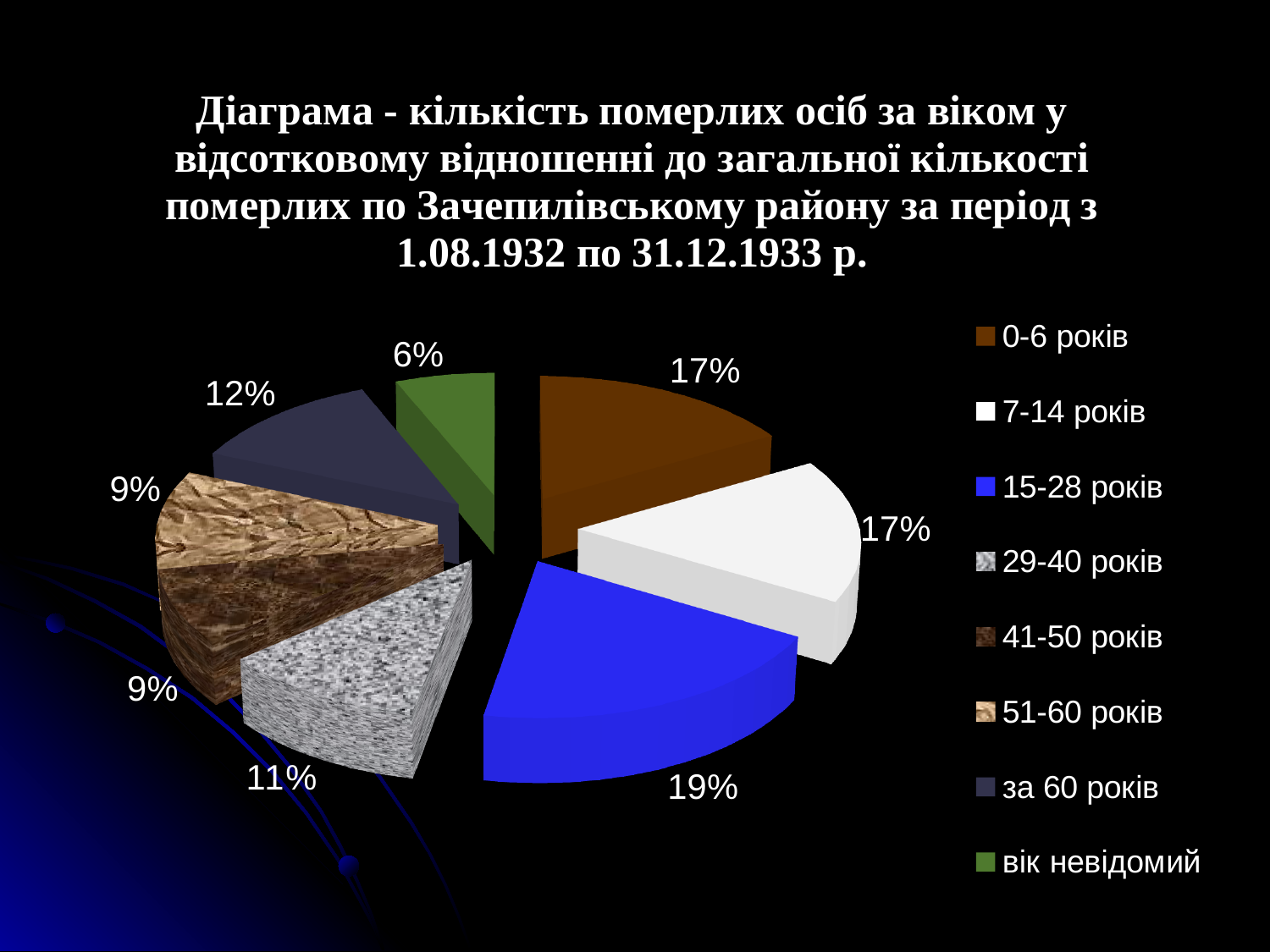
What percentage of the pie is the slice for за 60 років? 12% Which slice is larger: за 60 років or 41-50 років? за 60 років What percentage of the pie is the slice for 29-40 років? 11% What type of chart is shown on the slide? pie chart Which category has the smallest share of the pie? вік невідомий What is the difference in percentage points between the 15-28 років slice and the 29-40 років slice? 8 How many categories does the legend of the pie chart list? 8 What colour is the slice for 15-28 років? blue What percentage of the pie is the slice for вік невідомий? 6% Which age category has the largest share of the pie? 15-28 років What percentage of the pie is the slice for 0-6 років? 17% What percentage of the pie is the slice for 15-28 років? 19%